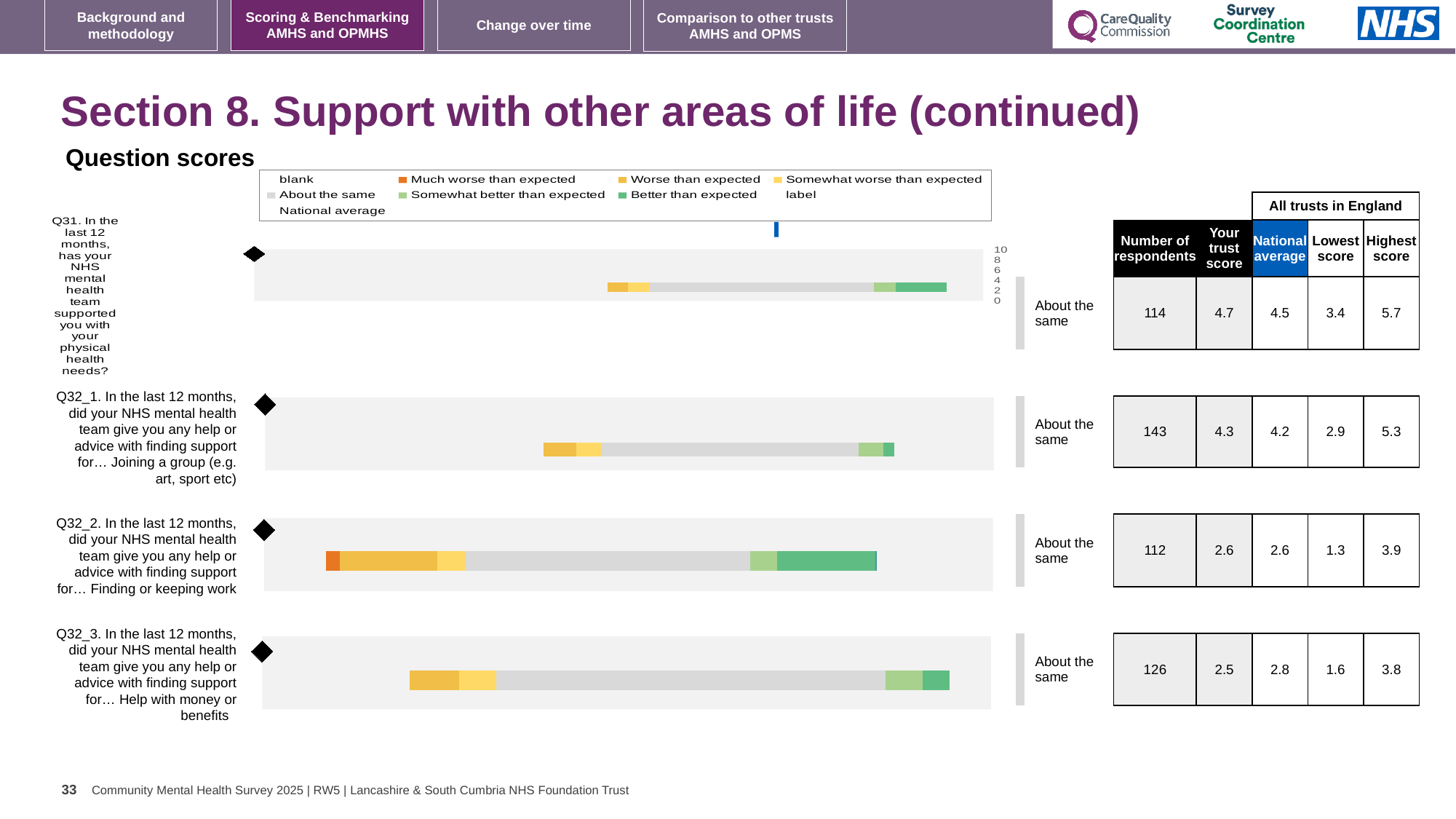
For Q32_2 (finding or keeping work), what is the national average score? 2.6 For Q32_3, which is larger: the trust score or the national average? National average Which question has the lowest 'Your trust score' on this slide? Q32_3 What benchmark category is shown next to the Q32_2 chart? About the same For Q31, how much higher is the trust score than the national average? 0.2 Which question has the highest 'Your trust score' on this slide? Q31 For Q31 (support with physical health needs), what is the trust's score shown in the table? 4.7 What kind of chart is used to show each question score? Bar chart For Q32_3 (help with money or benefits), what is the highest score among all trusts in England? 3.8 How many question bar charts are shown on this slide? 4 How many respondents answered Q32_1 (joining a group)? 143 For Q32_1, what is the difference between the highest score and the lowest score among all trusts? 2.4